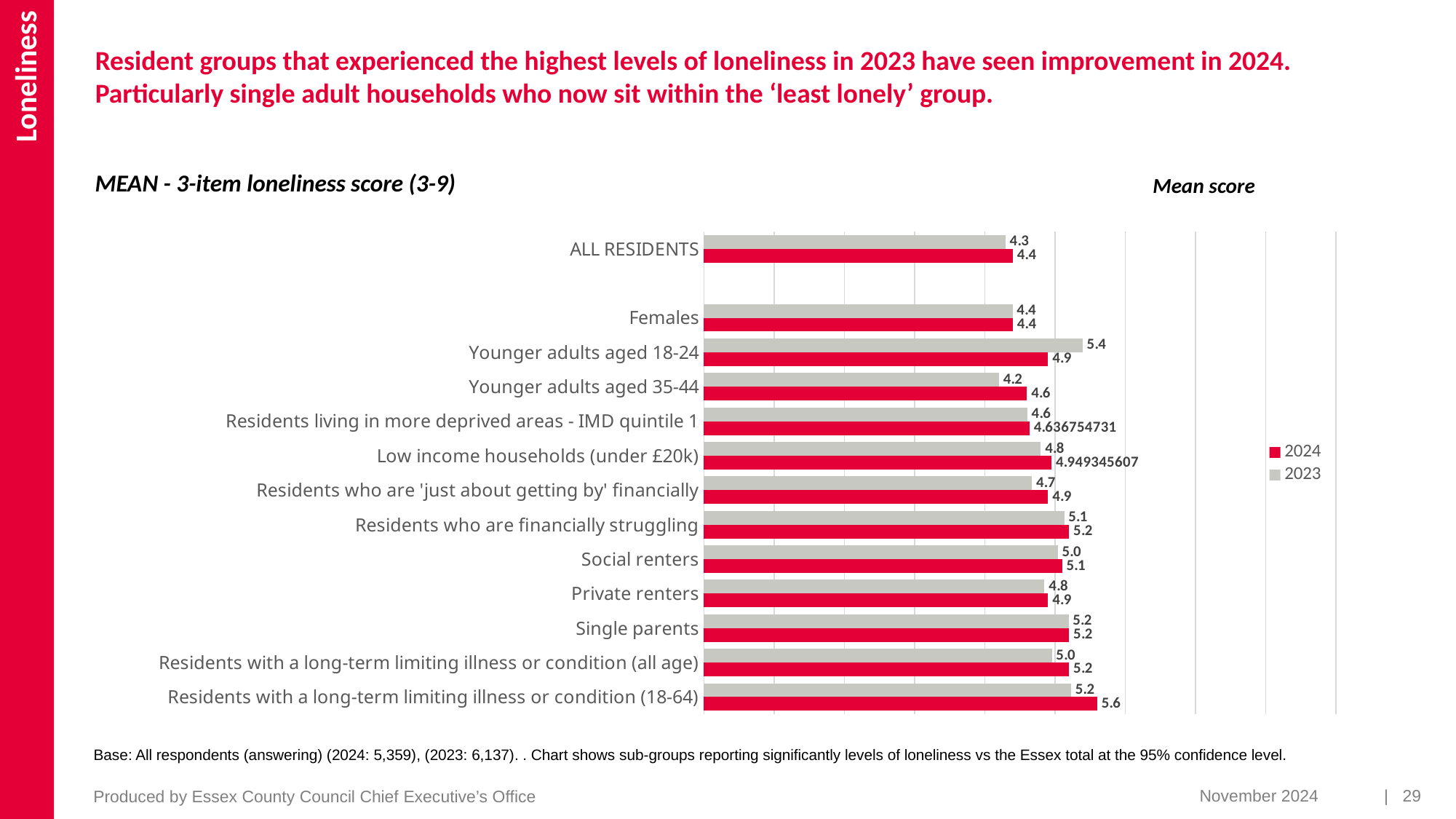
Which resident group has the lowest 2023 mean loneliness score? Younger adults aged 35-44 How many resident groups are shown on the chart? 13 Which colour represents the 2023 series in the chart? grey Which resident group has the highest 2023 mean loneliness score? Younger adults aged 18-24 Which resident group has the highest 2024 mean loneliness score? Residents with a long-term limiting illness or condition (18-64) What is the 2024 mean loneliness score for Residents with a long-term limiting illness or condition (18-64)? 5.6 What is the difference between the 2023 and 2024 mean scores for Younger adults aged 18-24? 0.5 What type of chart is shown on the slide? bar chart What is the 2023 mean loneliness score for Younger adults aged 35-44? 4.2 How many series does the legend list? 2 What is the 2024 mean loneliness score for Younger adults aged 18-24? 4.9 For Social renters, which year has the higher mean loneliness score, 2023 or 2024? 2024